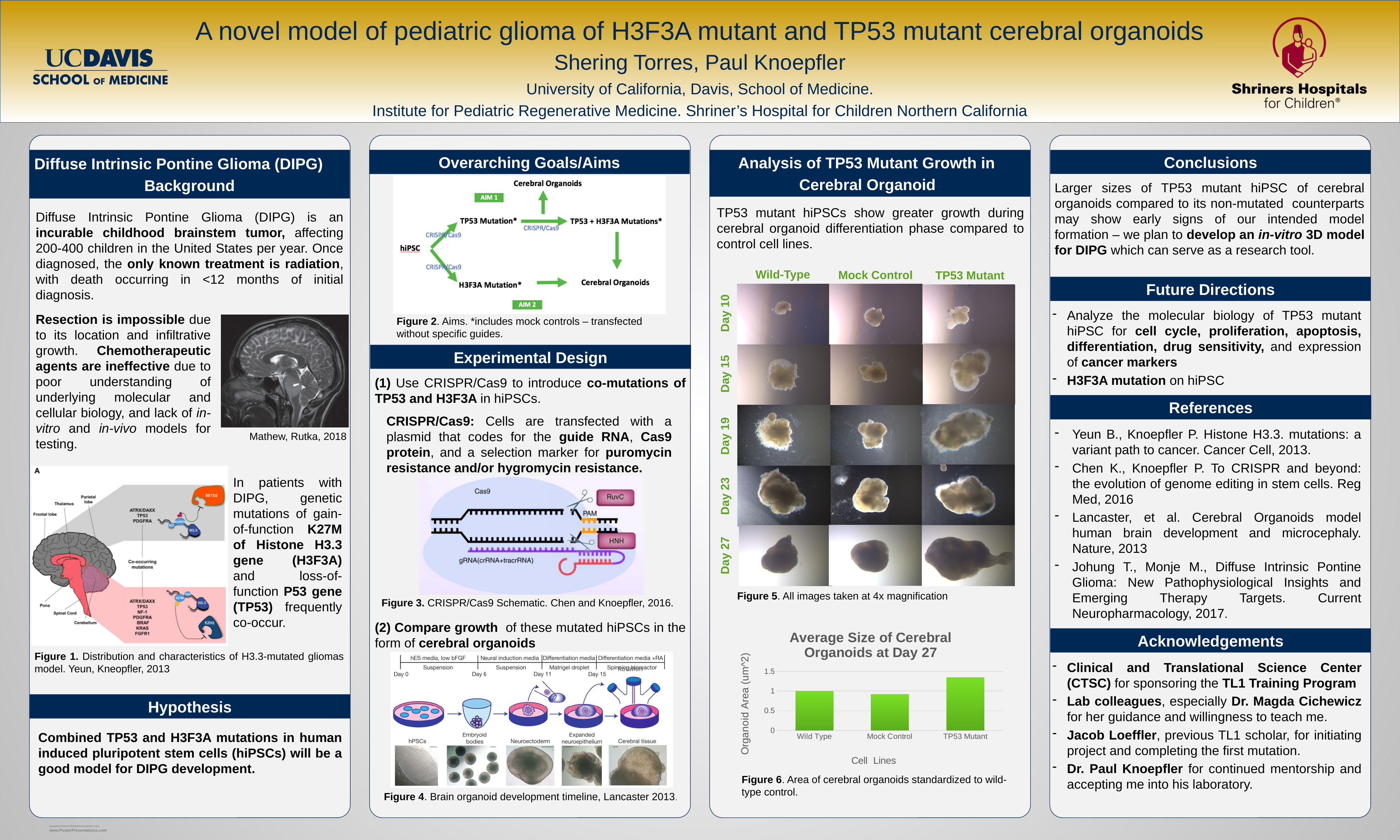
How many cell lines are plotted in the "Average Size of Cerebral Organoids at Day 27" chart? 3 What is the x-axis label of the "Average Size of Cerebral Organoids at Day 27" chart? Cell Lines In the "Average Size of Cerebral Organoids at Day 27" chart, is the value for TP53 Mutant greater or less than 1? greater Which cell line has the smallest organoid area in the "Average Size of Cerebral Organoids at Day 27" chart? Mock Control In the "Average Size of Cerebral Organoids at Day 27" chart, is the value for TP53 Mutant greater or less than 1.5? less What is the y-axis label of the "Average Size of Cerebral Organoids at Day 27" chart? Organoid Area (um^2) In the "Average Size of Cerebral Organoids at Day 27" chart, which is larger, the value for TP53 Mutant or the value for Wild Type? TP53 Mutant In the "Average Size of Cerebral Organoids at Day 27" chart, is the value for Mock Control greater or less than 0.5? greater In the "Average Size of Cerebral Organoids at Day 27" chart, what is the organoid area value for Wild Type? 1 What kind of chart is "Average Size of Cerebral Organoids at Day 27"? bar chart Which cell line has the largest organoid area in the "Average Size of Cerebral Organoids at Day 27" chart? TP53 Mutant